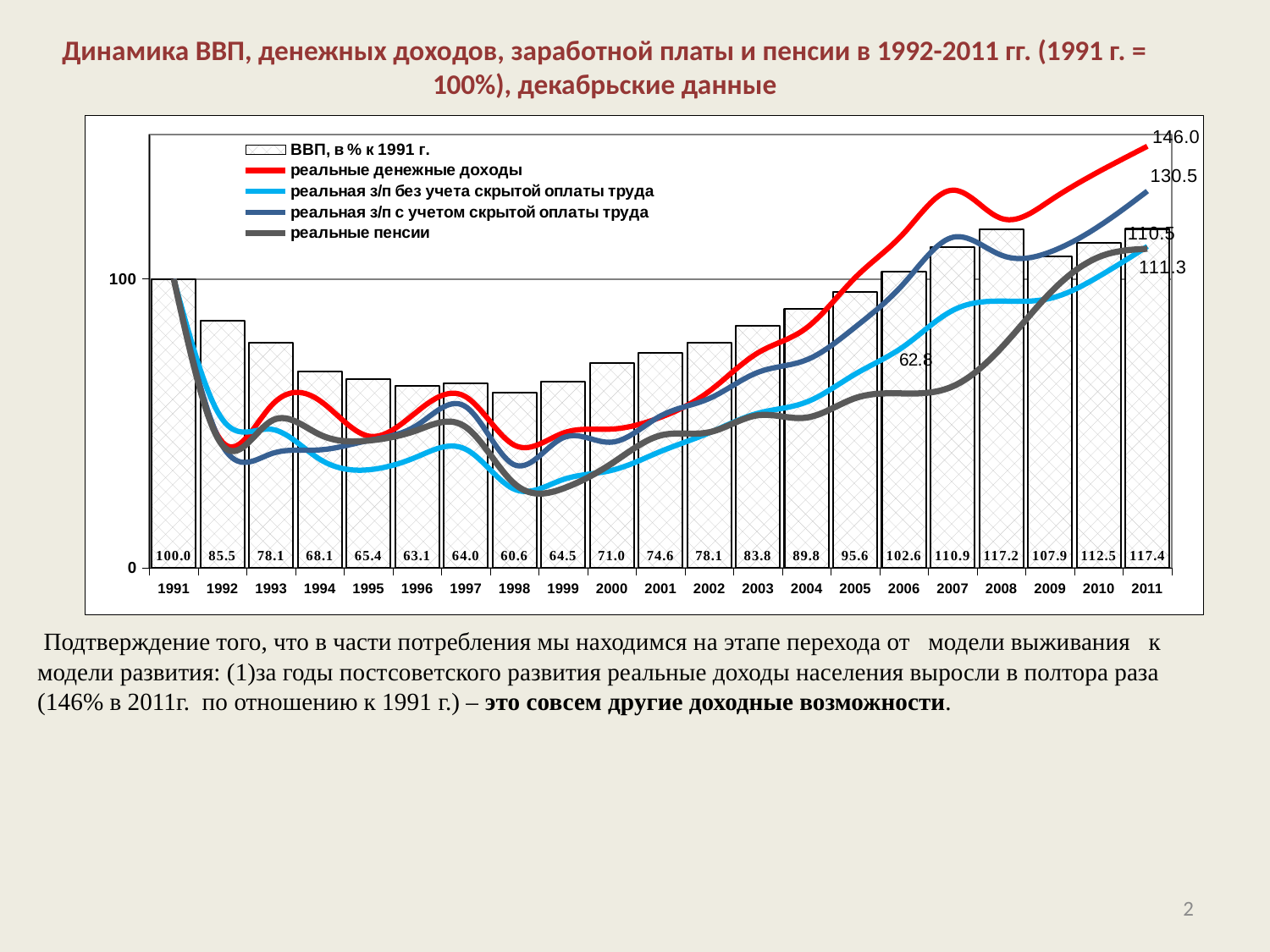
Which year has a higher ВВП value, 2005 or 2006? 2006 What is the value of ВВП, в % к 1991 г. for 2011? 117.4 How many years are shown on the x axis? 21 What kind of chart is this? Combined bar and line chart What is the value of ВВП, в % к 1991 г. for 1998? 60.6 How many series does the legend list? 5 Is the value of реальные денежные доходы in 2007 greater or less than 100? greater What value does the реальные денежные доходы line reach in 2011? 146.0 Do the ВВП bars rise or fall from 1991 to 1998? fall What is the value of ВВП, в % к 1991 г. for 2006? 102.6 What is the difference between the ВВП values for 2008 and 2009? 9.3 In which year is the ВВП bar the lowest? 1998